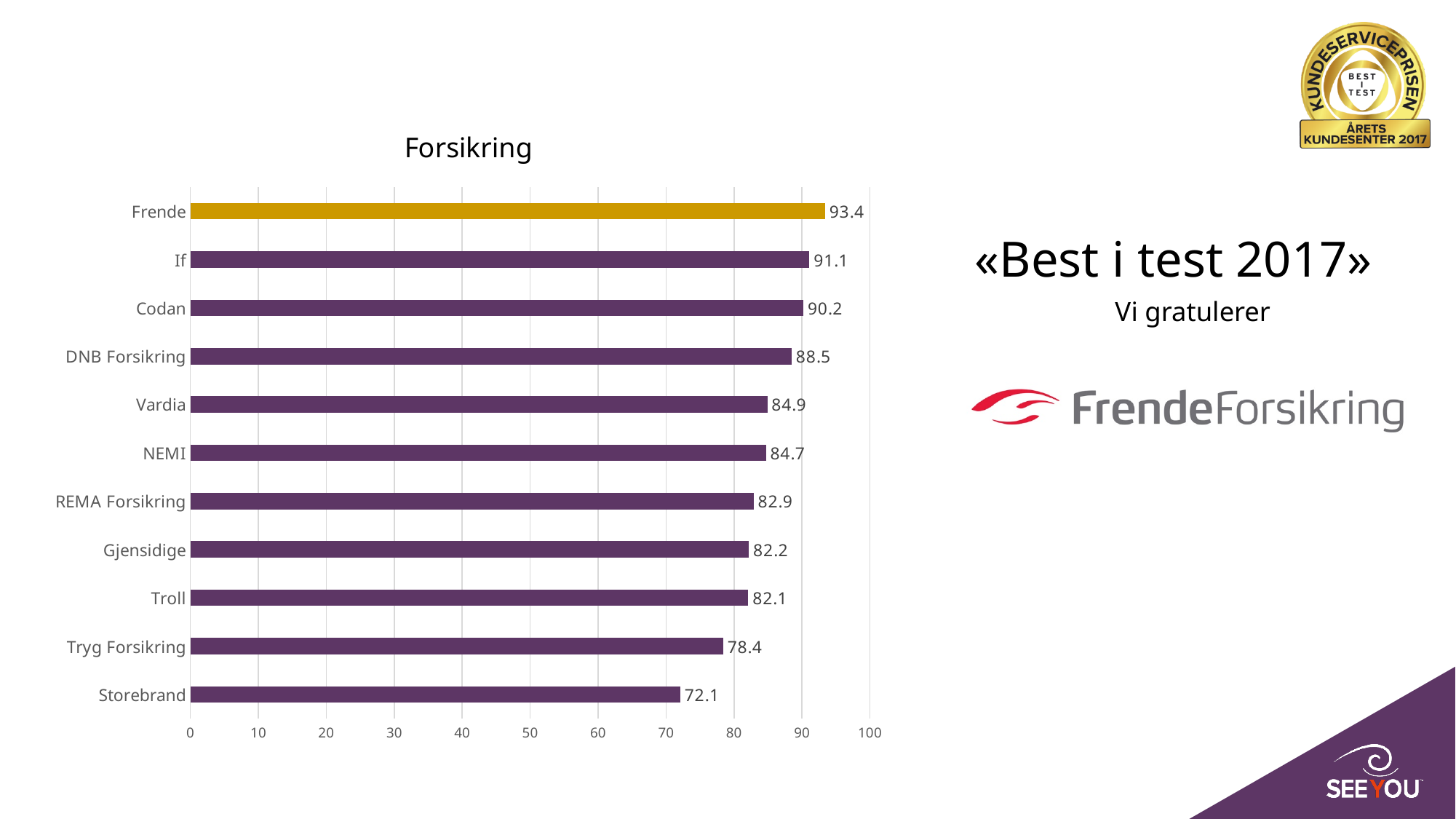
What is the value for DNB Forsikring? 88.5 What is the difference between the values for Frende and If? 2.3 Which is larger, the value for Codan or the value for Vardia? Codan What is the value for Storebrand? 72.1 Which category has the highest value? Frende Which category has the lowest value? Storebrand What is the title of the chart? Forsikring What is the difference between the values for Tryg Forsikring and Storebrand? 6.3 What kind of chart is shown on the slide? bar chart Is the value for Gjensidige greater or less than 80? greater How many categories are shown in the chart? 11 What is the value for Frende? 93.4